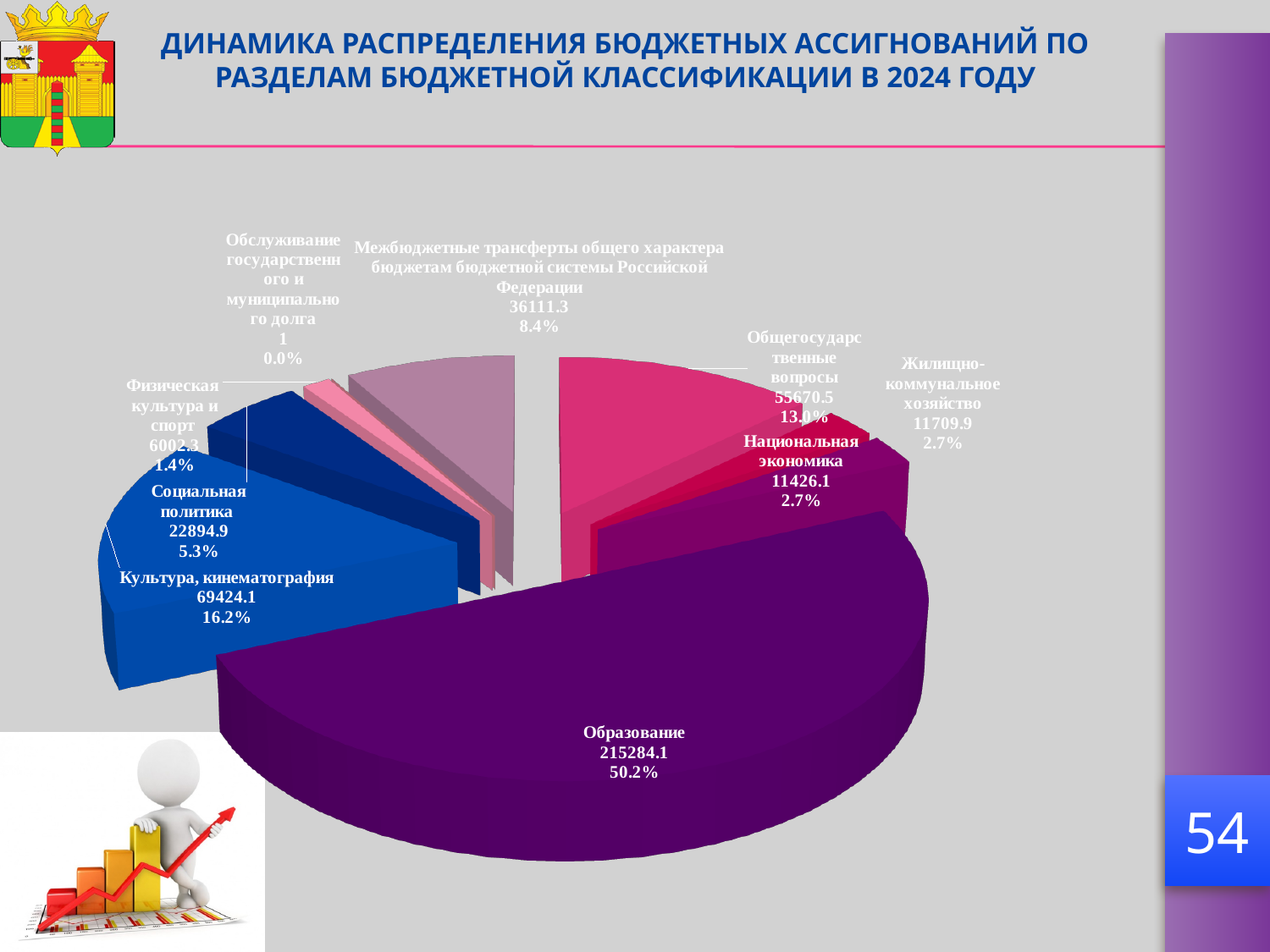
What is the value for Социальная политика? 22894.9 What is the value for Культура, кинематография? 69424.1 Which category has the smallest value? Обслуживание государственного и муниципального долга What is the difference between the values for Образование and Культура, кинематография? 145860.0 What share of the pie does Образование represent? 50.2% How many categories are shown in the pie chart? 9 Which category has the largest share of the pie? Образование What is the value for Образование? 215284.1 Which is larger, the value for Жилищно-коммунальное хозяйство or the value for Физическая культура и спорт? Жилищно-коммунальное хозяйство What year does the chart title refer to? 2024 What share of the pie does Общегосударственные вопросы represent? 13.0% What kind of chart is shown on the slide? Pie chart